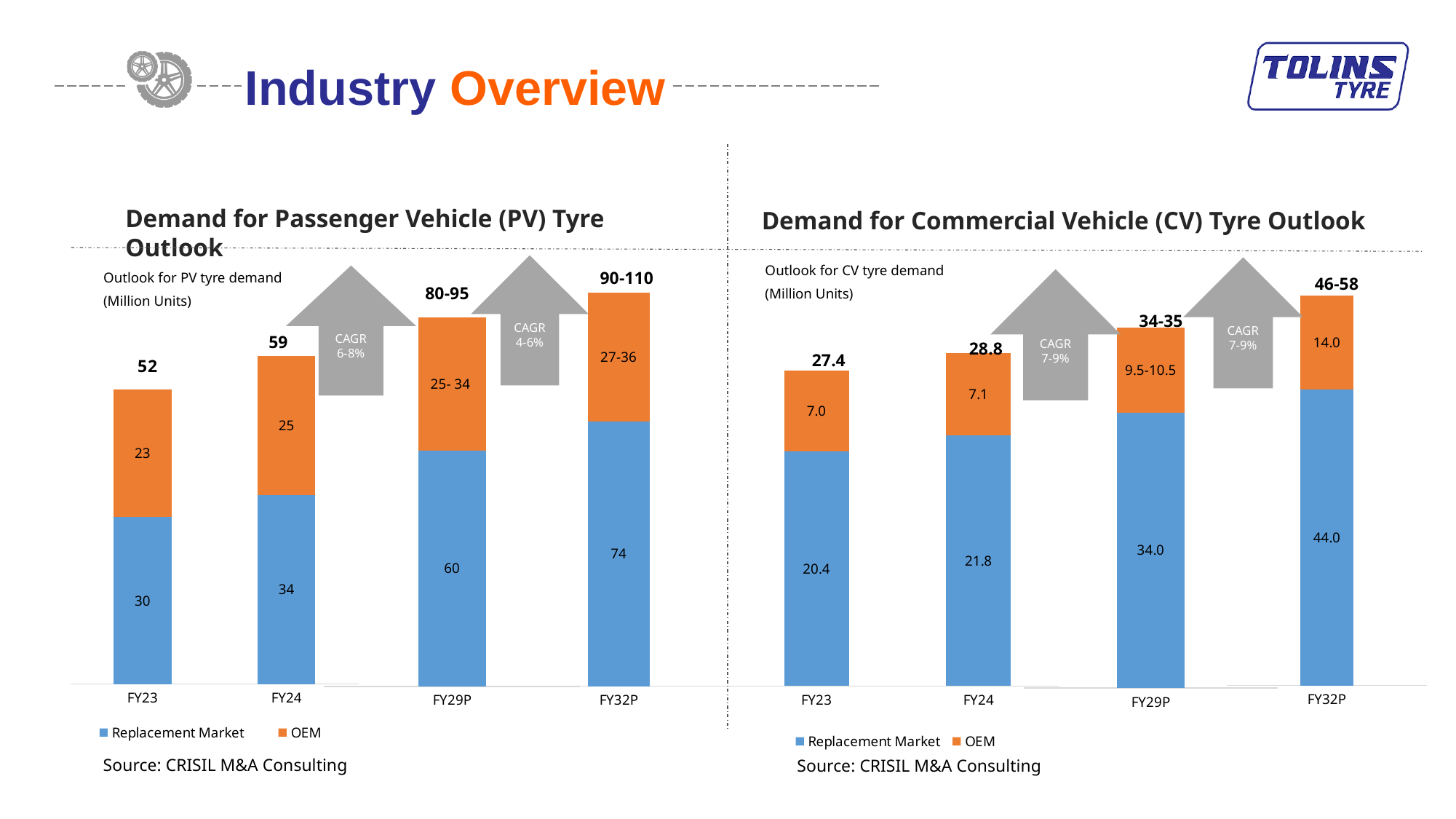
In the Demand for Commercial Vehicle (CV) Tyre Outlook chart, what is the Replacement Market value for FY29P? 34.0 In the Demand for Passenger Vehicle (PV) Tyre Outlook chart, what is the difference between the Replacement Market values for FY24 and FY23? 4 How many series does the legend of the Demand for Commercial Vehicle (CV) Tyre Outlook chart list? 2 In the Demand for Passenger Vehicle (PV) Tyre Outlook chart, what is the total demand shown for FY32P? 90-110 What kind of chart is the Demand for Passenger Vehicle (PV) Tyre Outlook chart? Stacked bar chart In the Demand for Commercial Vehicle (CV) Tyre Outlook chart, what is the total demand shown for FY24? 28.8 In the Demand for Commercial Vehicle (CV) Tyre Outlook chart, what is the OEM value for FY32P? 14.0 In the Demand for Passenger Vehicle (PV) Tyre Outlook chart, what is the Replacement Market value for FY23? 30 How many categories are shown on the x axis of the Demand for Passenger Vehicle (PV) Tyre Outlook chart? 4 In the Demand for Commercial Vehicle (CV) Tyre Outlook chart, is the Replacement Market value larger for FY32P or FY29P? FY32P In the Demand for Commercial Vehicle (CV) Tyre Outlook chart, which year has the lowest total demand? FY23 In the Demand for Passenger Vehicle (PV) Tyre Outlook chart, what is the OEM value for FY24? 25